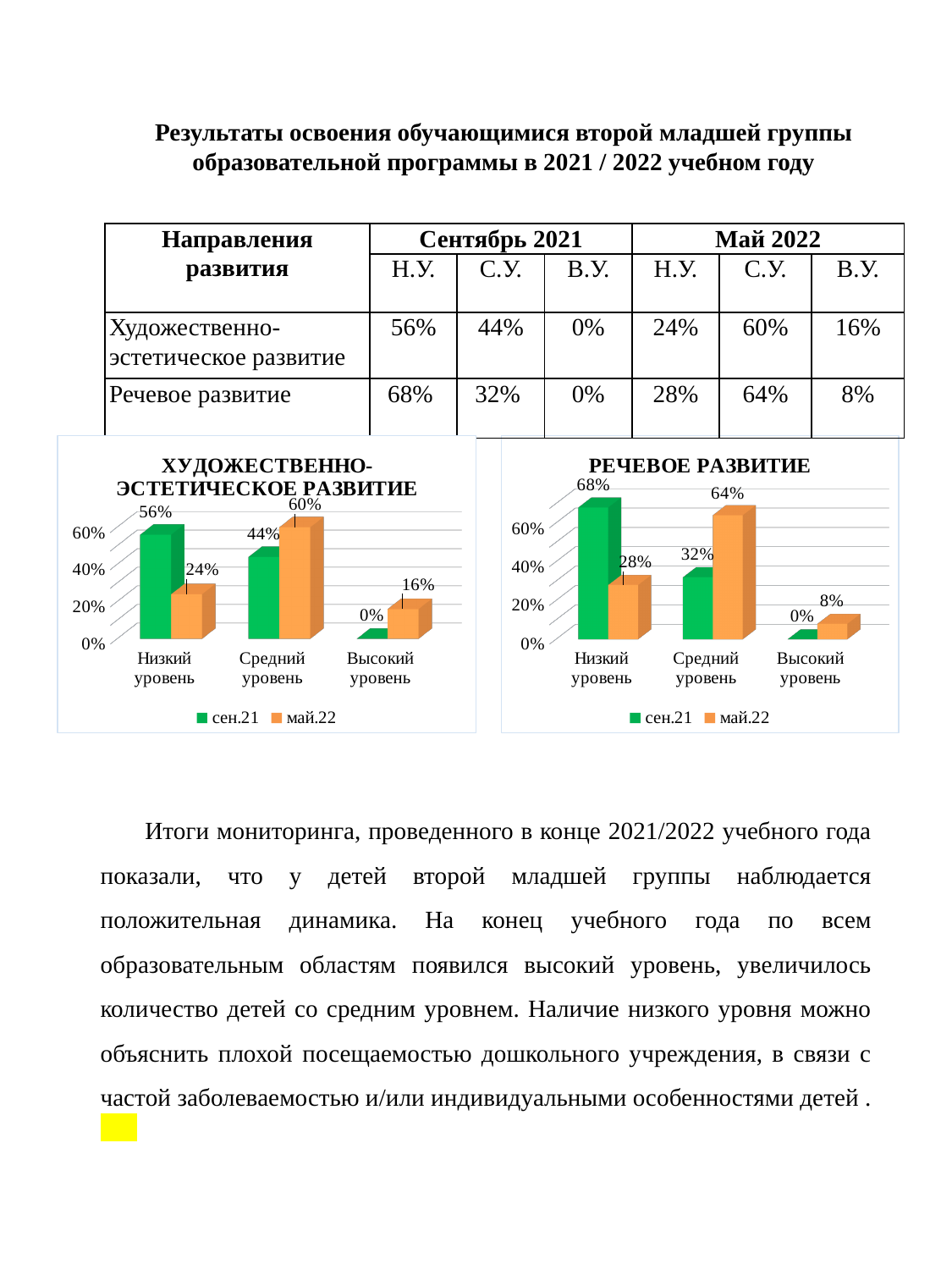
How many series does the legend of the chart titled "РЕЧЕВОЕ РАЗВИТИЕ" list? 2 In the chart titled "РЕЧЕВОЕ РАЗВИТИЕ", which category has the highest value for сен.21? Низкий уровень In the chart titled "РЕЧЕВОЕ РАЗВИТИЕ", which is larger at Низкий уровень: сен.21 or май.22? сен.21 In the chart titled "ХУДОЖЕСТВЕННО-ЭСТЕТИЧЕСКОЕ РАЗВИТИЕ", which category has the lowest value for май.22? Высокий уровень In the chart titled "ХУДОЖЕСТВЕННО-ЭСТЕТИЧЕСКОЕ РАЗВИТИЕ", what is the value for сен.21 at Низкий уровень? 56% In the chart titled "РЕЧЕВОЕ РАЗВИТИЕ", what is the value for май.22 at Средний уровень? 64% In the chart titled "РЕЧЕВОЕ РАЗВИТИЕ", what is the difference between the май.22 and сен.21 values at Средний уровень? 32% In the chart titled "ХУДОЖЕСТВЕННО-ЭСТЕТИЧЕСКОЕ РАЗВИТИЕ", what is the value for май.22 at Высокий уровень? 16% In the chart titled "ХУДОЖЕСТВЕННО-ЭСТЕТИЧЕСКОЕ РАЗВИТИЕ", what is the difference between the сен.21 and май.22 values at Низкий уровень? 32% How many categories are shown on the x axis of the chart titled "ХУДОЖЕСТВЕННО-ЭСТЕТИЧЕСКОЕ РАЗВИТИЕ"? 3 In the chart titled "РЕЧЕВОЕ РАЗВИТИЕ", what is the value for сен.21 at Высокий уровень? 0% What type of chart is the chart titled "РЕЧЕВОЕ РАЗВИТИЕ"? Bar chart